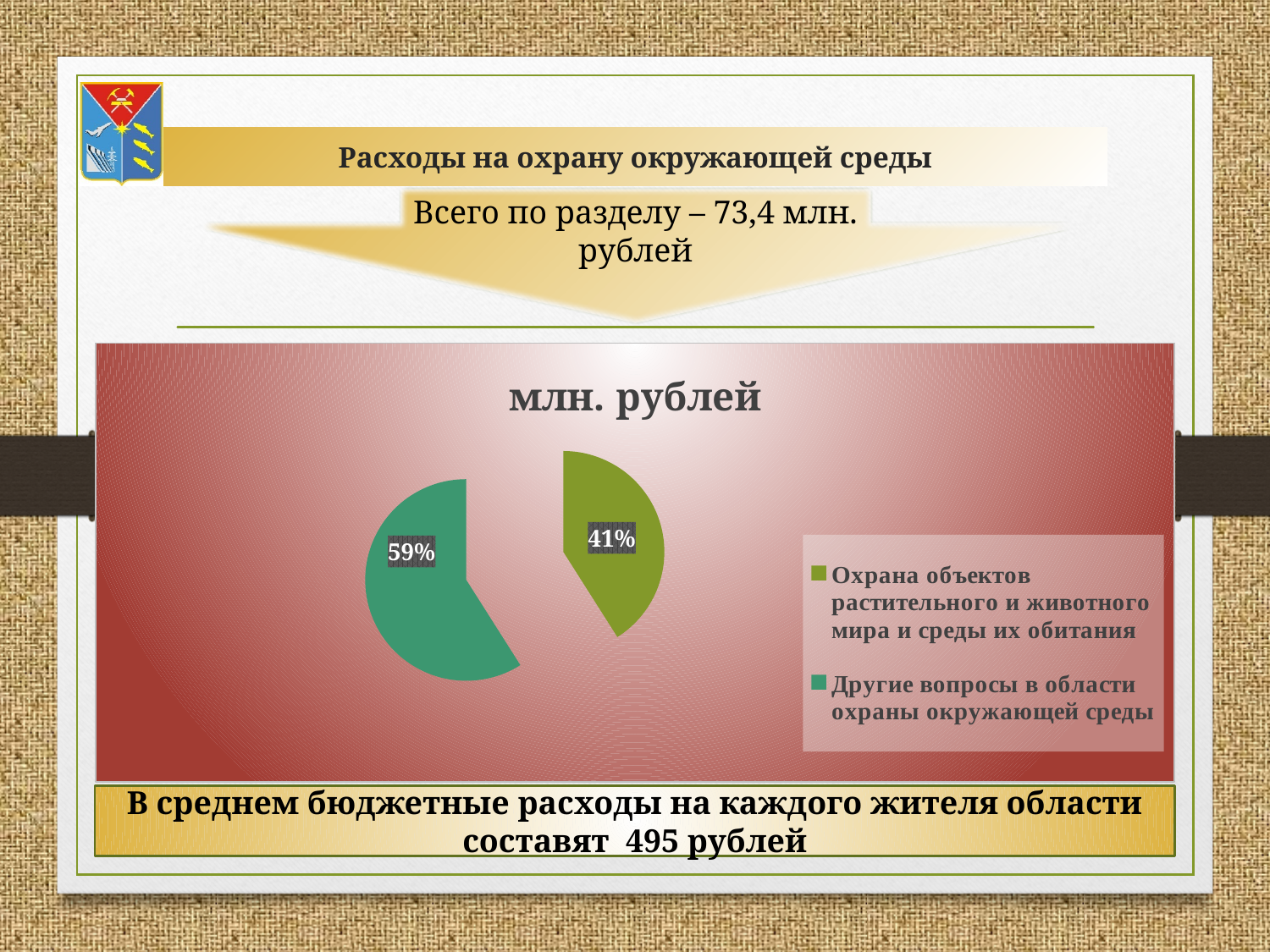
What share of the pie is labelled for "Другие вопросы в области охраны окружающей среды"? 59% How many entries does the legend list? 2 How many slices does the pie chart have? 2 What colour is the slice for "Охрана объектов растительного и животного мира и среды их обитания"? green Which category has the smallest slice of the pie? Охрана объектов растительного и животного мира и среды их обитания Which is larger: the slice for "Охрана объектов растительного и животного мира и среды их обитания" or the slice for "Другие вопросы в области охраны окружающей среды"? Другие вопросы в области охраны окружающей среды Which category has the largest slice of the pie? Другие вопросы в области охраны окружающей среды What is the chart's title? млн. рублей What is the difference in percentage points between the two slices of the pie? 18 What share of the pie is labelled for "Охрана объектов растительного и животного мира и среды их обитания"? 41% What kind of chart is shown on the slide? pie chart